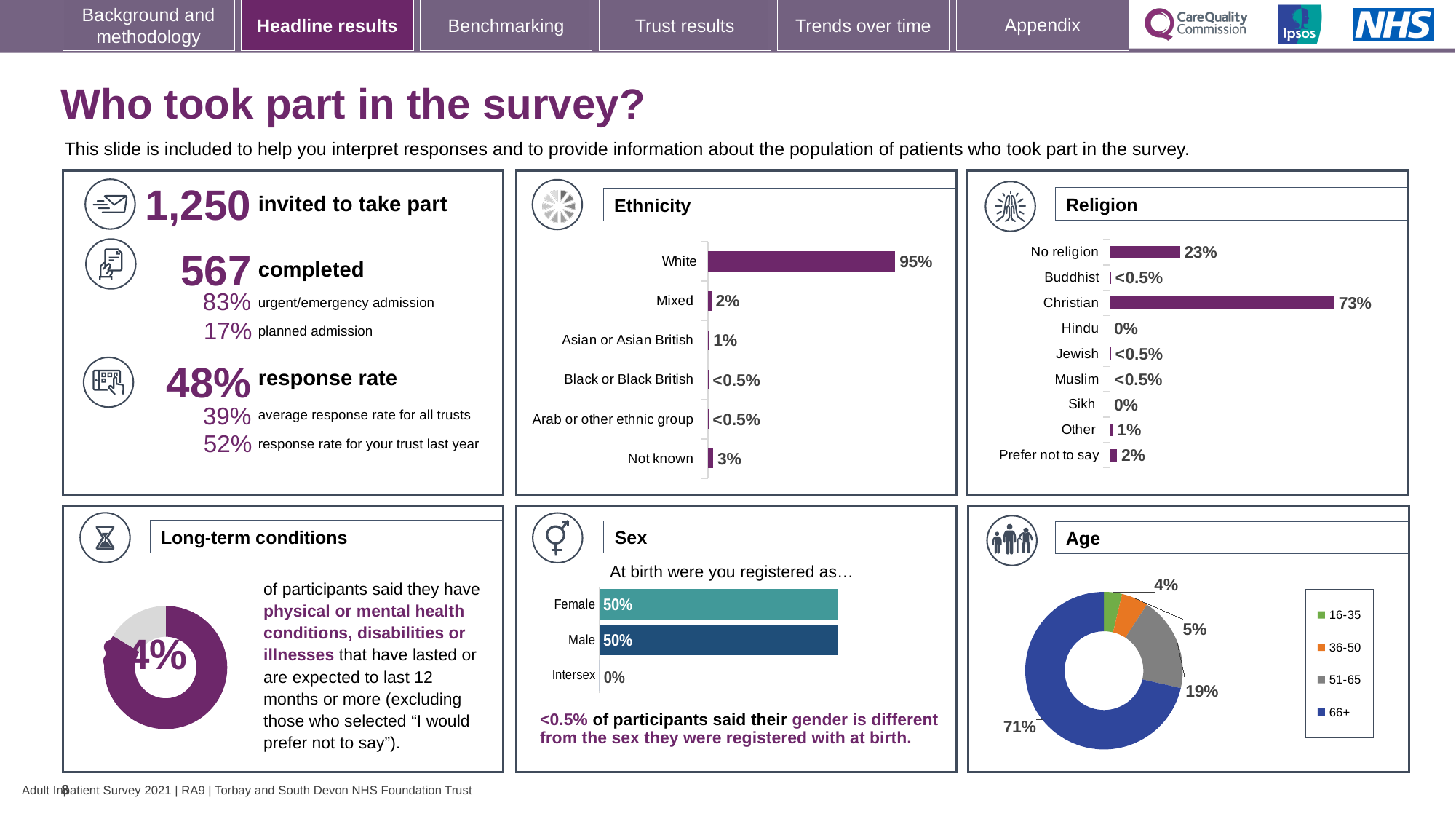
In the Religion chart, what percentage of participants were Christian? 73% In the Ethnicity chart, what percentage of participants were White? 95% In the Religion chart, which is larger, the value for No religion or the value for Other? No religion In the Ethnicity chart, which ethnic group has the highest percentage? White In the Age chart, what share of participants were aged 66+? 71% In the Sex chart, what percentage of participants were registered as Female at birth? 50% In the Ethnicity chart, what is the value for Not known? 3% In the Ethnicity chart, how many ethnic group categories are shown? 6 What kind of chart is the Age chart? Doughnut chart In the Religion chart, what is the value for Prefer not to say? 2% In the Religion chart, what is the difference between the Christian and No religion percentages? 50% In the Age chart, how many age groups does the legend list? 4